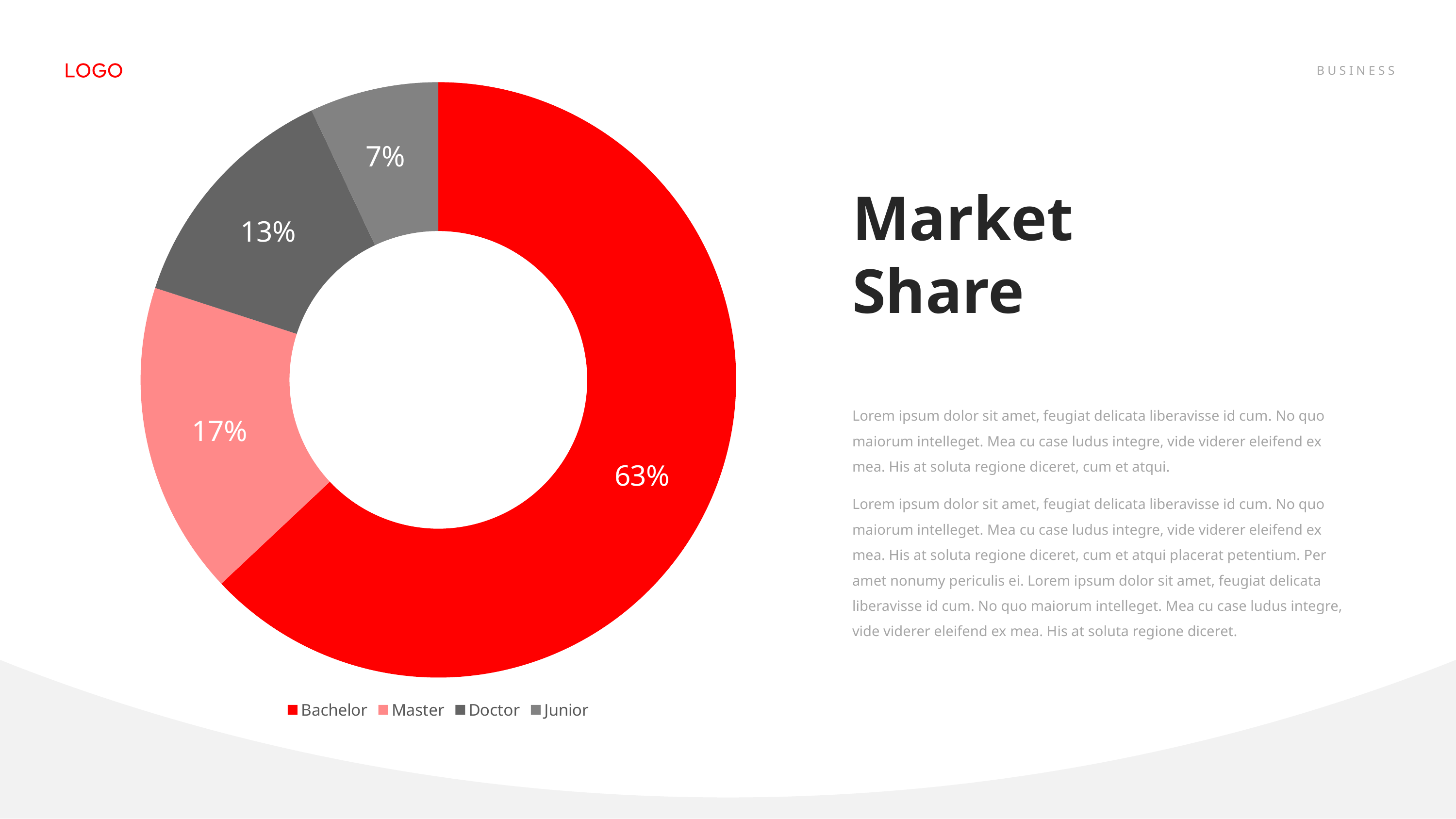
What share of the doughnut chart does Bachelor hold? 63% What colour is the Bachelor slice in the chart? Red What is the difference in percentage points between the Doctor and Junior slices? 6 Which slice is larger, Master or Doctor? Master What kind of chart is shown on the slide? Doughnut chart What share of the doughnut chart does Master hold? 17% How many categories does the chart show? 4 What share of the doughnut chart does Junior hold? 7% Which category has the largest slice in the chart? Bachelor Which category has the smallest slice in the chart? Junior What is the difference in percentage points between the Bachelor and Master slices? 46 What share of the doughnut chart does Doctor hold? 13%